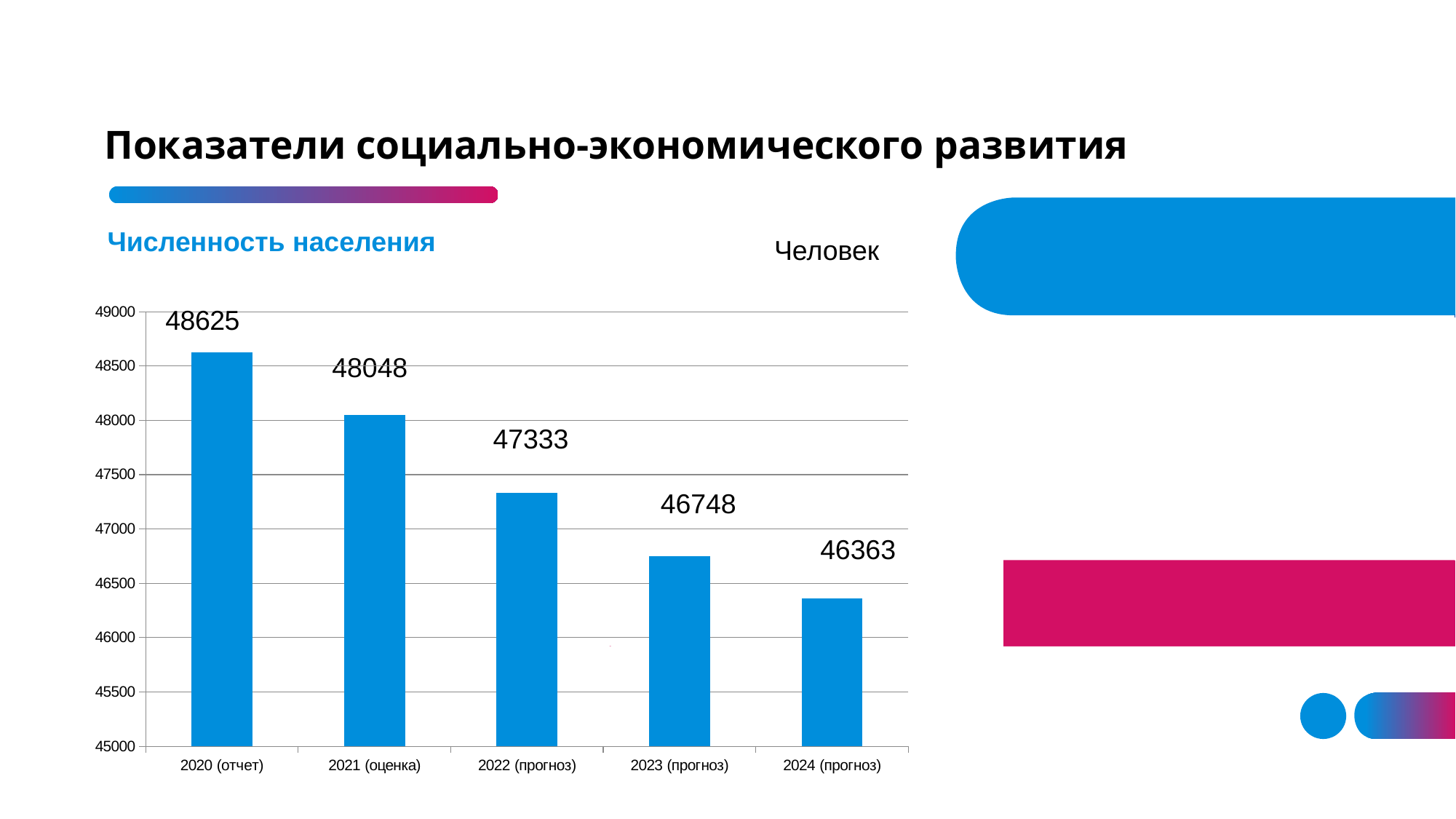
How many years are shown on the x axis of the chart? 5 Which is larger, the population value for 2021 (оценка) or for 2023 (прогноз)? 2021 (оценка) What is the difference between the population values for 2023 (прогноз) and 2024 (прогноз)? 385 What is the population value shown for 2022 (прогноз)? 47333 Which year has the lowest population value? 2024 (прогноз) Is the population value for 2022 (прогноз) greater or less than 47500? less What kind of chart is used to show the population figures? bar chart What is the population value shown for 2024 (прогноз)? 46363 Which year has the highest population value? 2020 (отчет) Do the population values rise or fall from 2020 to 2024? fall What is the population value shown for 2020 (отчет)? 48625 What is the difference between the population values for 2020 (отчет) and 2021 (оценка)? 577